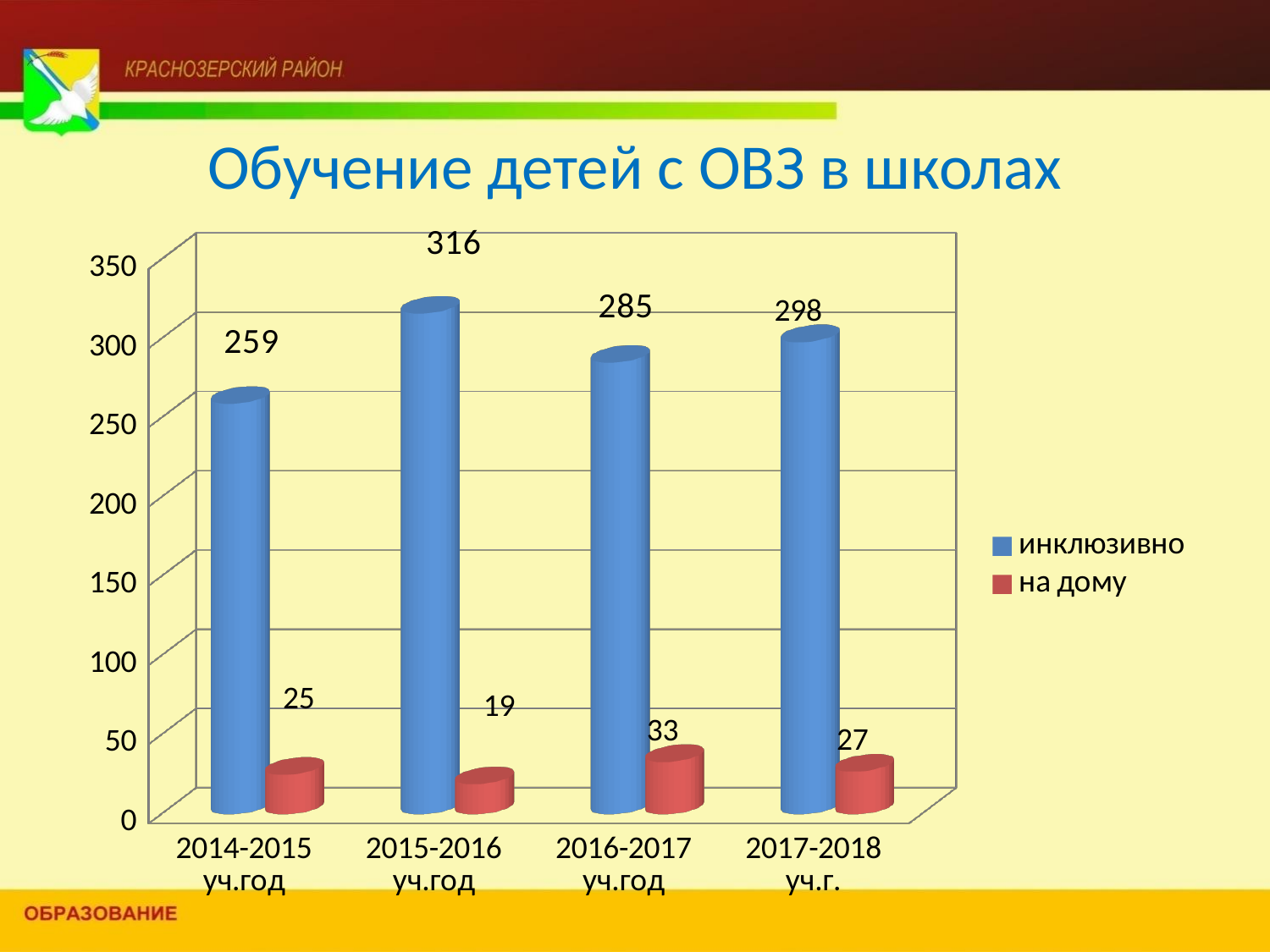
What is the title of the chart? Обучение детей с ОВЗ в школах Is the value for инклюзивно in 2014-2015 уч.год greater or less than 250? greater What is the difference between the инклюзивно values for 2015-2016 уч.год and 2014-2015 уч.год? 57 Which is larger: the на дому value for 2014-2015 уч.год or for 2017-2018 уч.г.? 2017-2018 уч.г. What is the value for инклюзивно in 2017-2018 уч.г.? 298 Which school year has the highest value for инклюзивно? 2015-2016 уч.год How many school years are shown on the x axis? 4 What is the value for инклюзивно in 2015-2016 уч.год? 316 How many series does the legend list? 2 Which school year has the lowest value for на дому? 2015-2016 уч.год What is the value for на дому in 2016-2017 уч.год? 33 What kind of chart is shown on the slide? bar chart